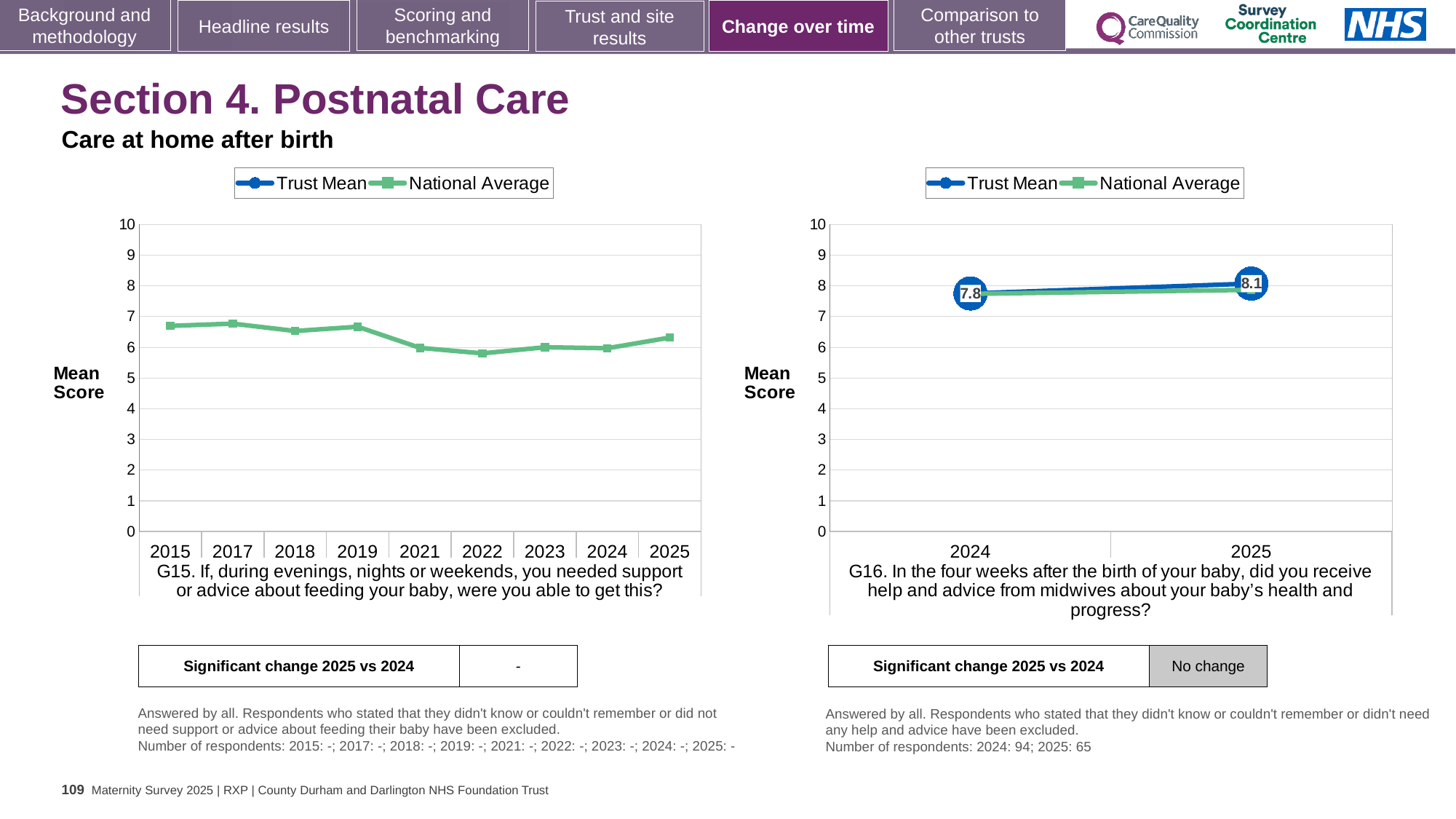
In the right chart (G16), what is the Trust Mean score for 2024? 7.8 What is the result shown for 'Significant change 2025 vs 2024' under the right chart (G16)? No change In the right chart (G16), what is the Trust Mean score for 2025? 8.1 In the right chart (G16), is the Trust Mean higher in 2024 or 2025? 2025 What kind of chart is the left chart (G15)? line chart In the left chart (G15), is the National Average for 2015 greater or less than 6? greater In the right chart (G16), does the Trust Mean rise or fall from 2024 to 2025? rise How many years are shown on the x axis of the left chart (G15)? 9 In the right chart (G16), by how much did the Trust Mean change from 2024 to 2025? 0.3 In the left chart (G15), which year has the lowest National Average? 2022 In the left chart (G15), is the National Average for 2022 greater or less than 7? less How many series does the legend of the right chart (G16) list? 2